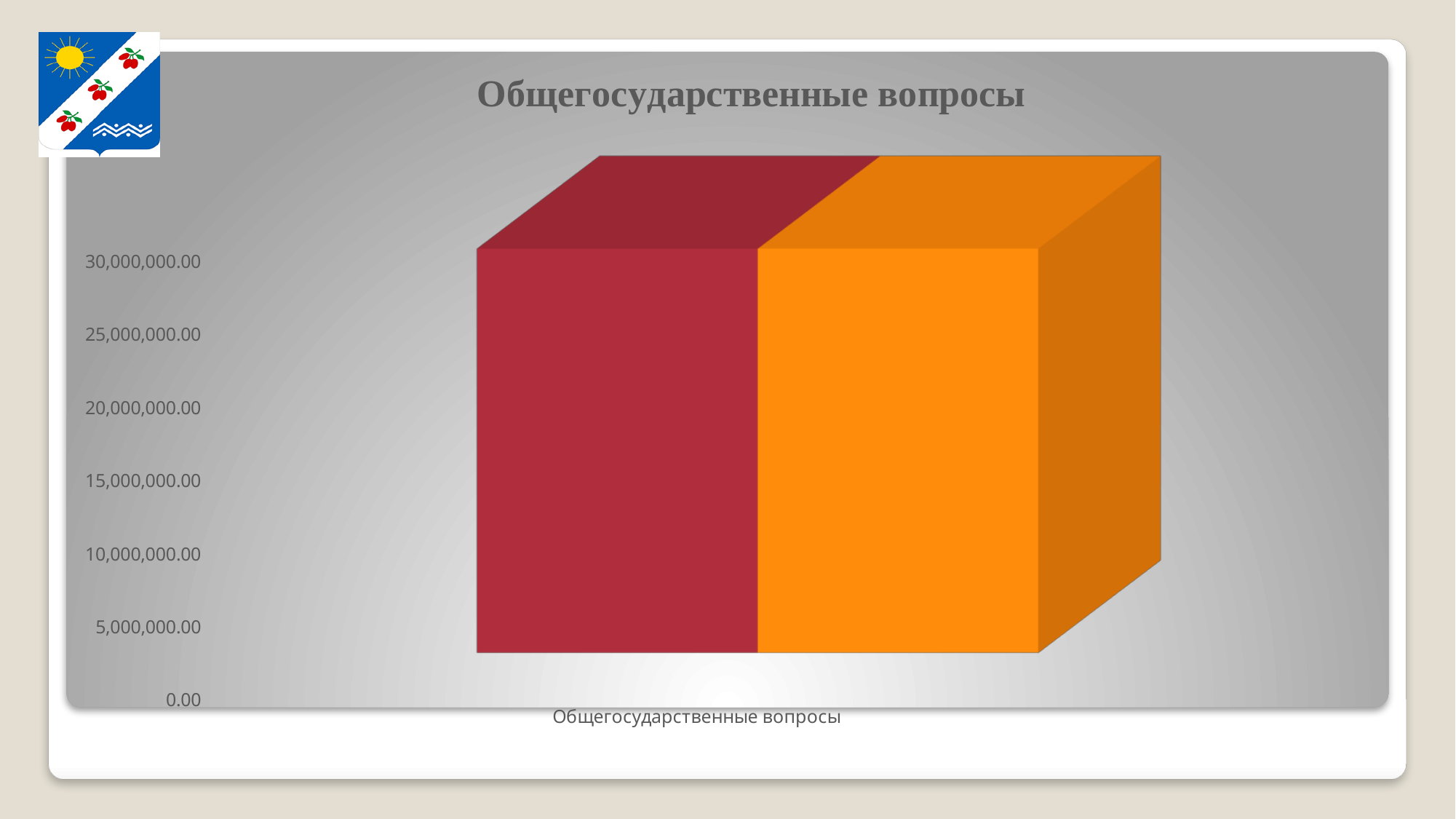
What is the title of the chart? Общегосударственные вопросы What kind of chart is shown on the slide? bar chart How many bars are plotted in the chart? 2 How many categories are shown on the x axis of the chart? 1 What is the highest tick value shown on the y axis of the chart? 30,000,000.00 Is the value of the orange bar greater or less than 10,000,000.00? greater Is the value of the orange bar greater or less than 20,000,000.00? greater What is the category label on the x axis of the chart? Общегосударственные вопросы Is the value of the red bar greater or less than 15,000,000.00? greater